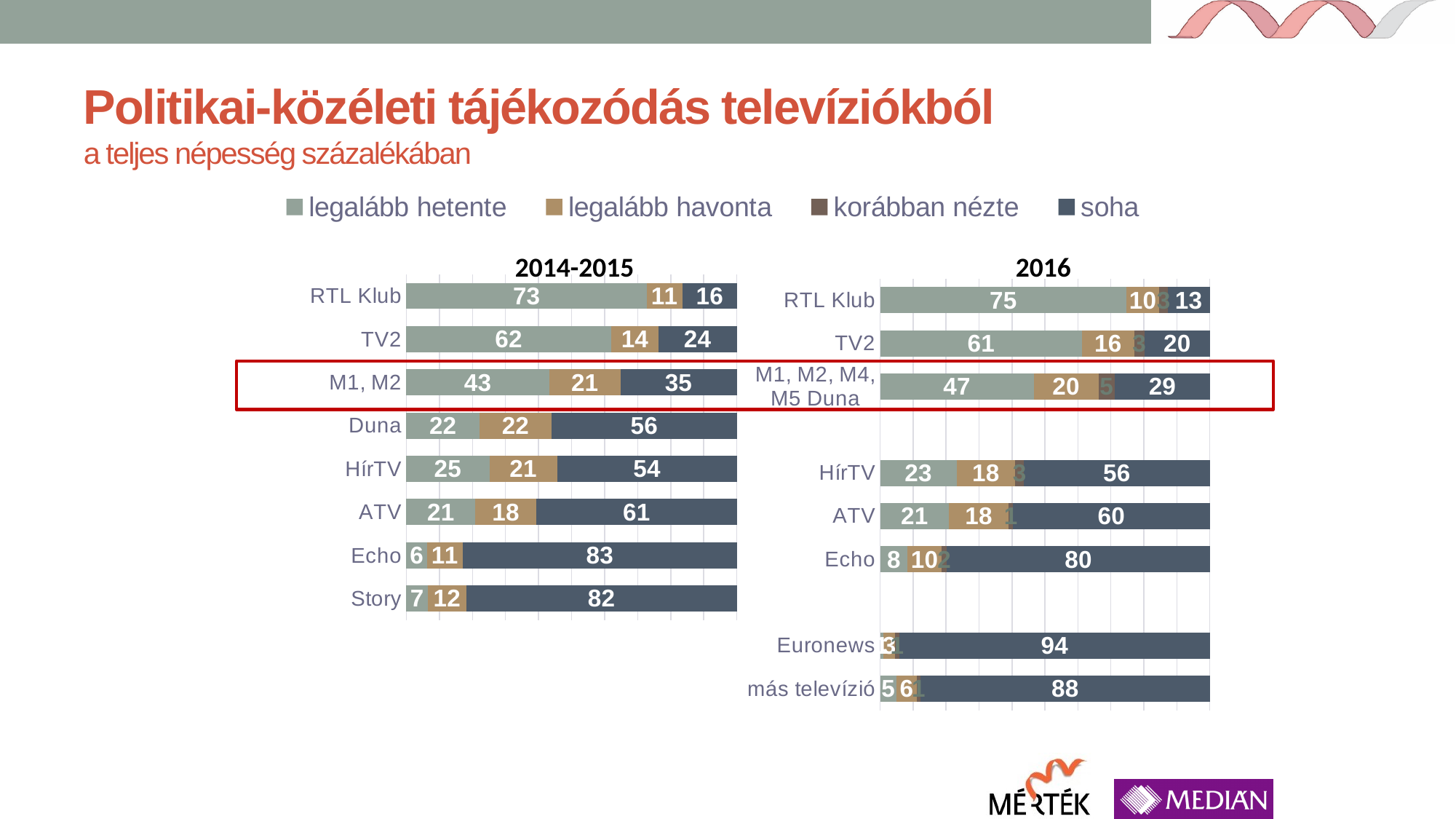
In the 2016 chart, what is the 'soha' value for HírTV? 56 What kind of chart is the 2016 chart? Stacked bar chart In the 2016 chart, what is the 'korábban nézte' value for M1, M2, M4, M5 Duna? 5 In the 2014-2015 chart, which channel has the lowest 'legalább hetente' value? Echo How many series does the legend list? 4 In the 2014-2015 chart, which channel has the highest 'soha' value? Echo In the 2014-2015 chart, what is the 'legalább hetente' value for RTL Klub? 73 In the 2014-2015 chart, what is the difference between the 'soha' values for Duna and HírTV? 2 In the 2016 chart, which is larger: the 'legalább hetente' value for HírTV or for ATV? HírTV In the 2016 chart, which channel has the highest 'legalább hetente' value? RTL Klub How many channels are shown in the 2014-2015 chart? 8 In the 2016 chart, what is the 'legalább havonta' value for TV2? 16